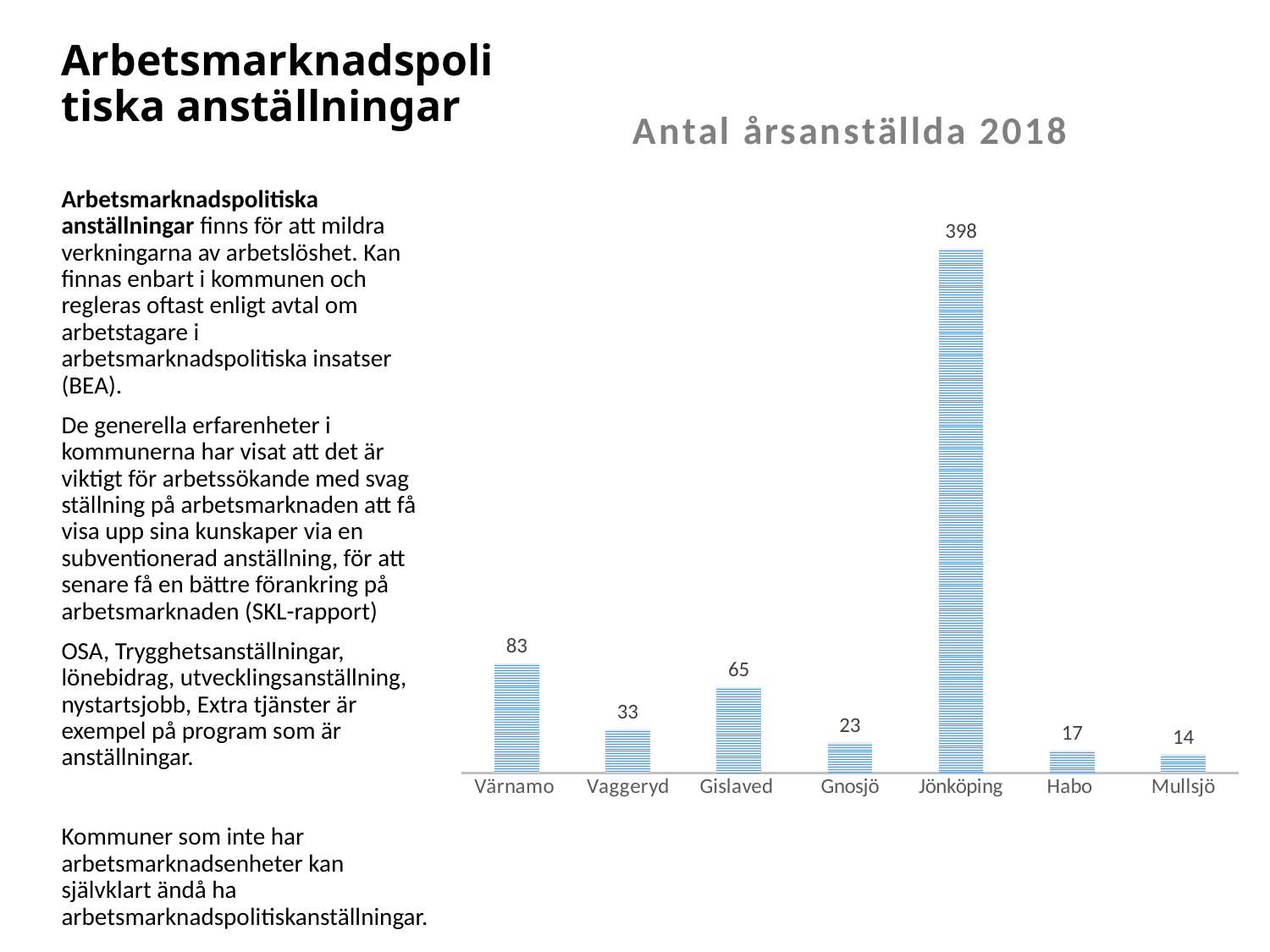
What is the title of the chart? Antal årsanställda 2018 Which category has the highest value? Jönköping What kind of chart is shown on the slide? Bar chart What is the difference between the values for Habo and Mullsjö? 3 What is the value for Jönköping? 398 Which is larger, the value for Vaggeryd or the value for Gnosjö? Vaggeryd What is the value for Habo? 17 How many categories are shown on the x axis? 7 What is the value for Värnamo? 83 Which category has the lowest value? Mullsjö What is the value for Gnosjö? 23 What is the difference between the values for Värnamo and Gislaved? 18